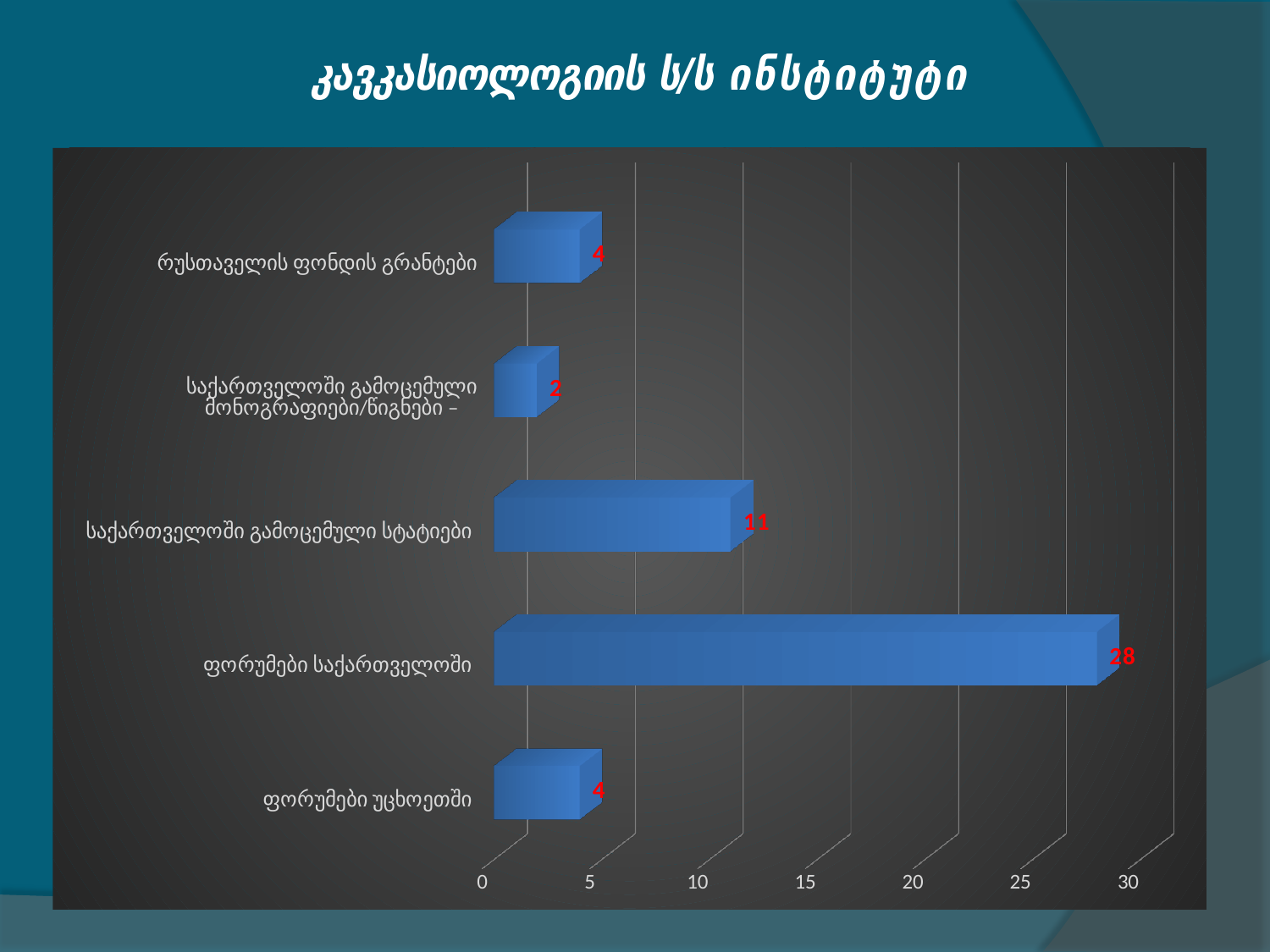
What is the title of the slide containing the chart? კავკასიოლოგიის ს/ს ინსტიტუტი What is the value for საქართველოში გამოცემული სტატიები? 11 What type of chart is shown on the slide? bar chart Which category has the lowest value? საქართველოში გამოცემული მონოგრაფიები/წიგნები How many categories are plotted in the chart? 5 What is the value for რუსთაველის ფონდის გრანტები? 4 What is the value for ფორუმები საქართველოში? 28 What is the difference between the values for ფორუმები საქართველოში and საქართველოში გამოცემული სტატიები? 17 What is the value for საქართველოში გამოცემული მონოგრაფიები/წიგნები? 2 Which is larger, the value for საქართველოში გამოცემული სტატიები or the value for ფორუმები უცხოეთში? საქართველოში გამოცემული სტატიები Is the value for ფორუმები საქართველოში greater or less than 25? greater Which category has the highest value? ფორუმები საქართველოში